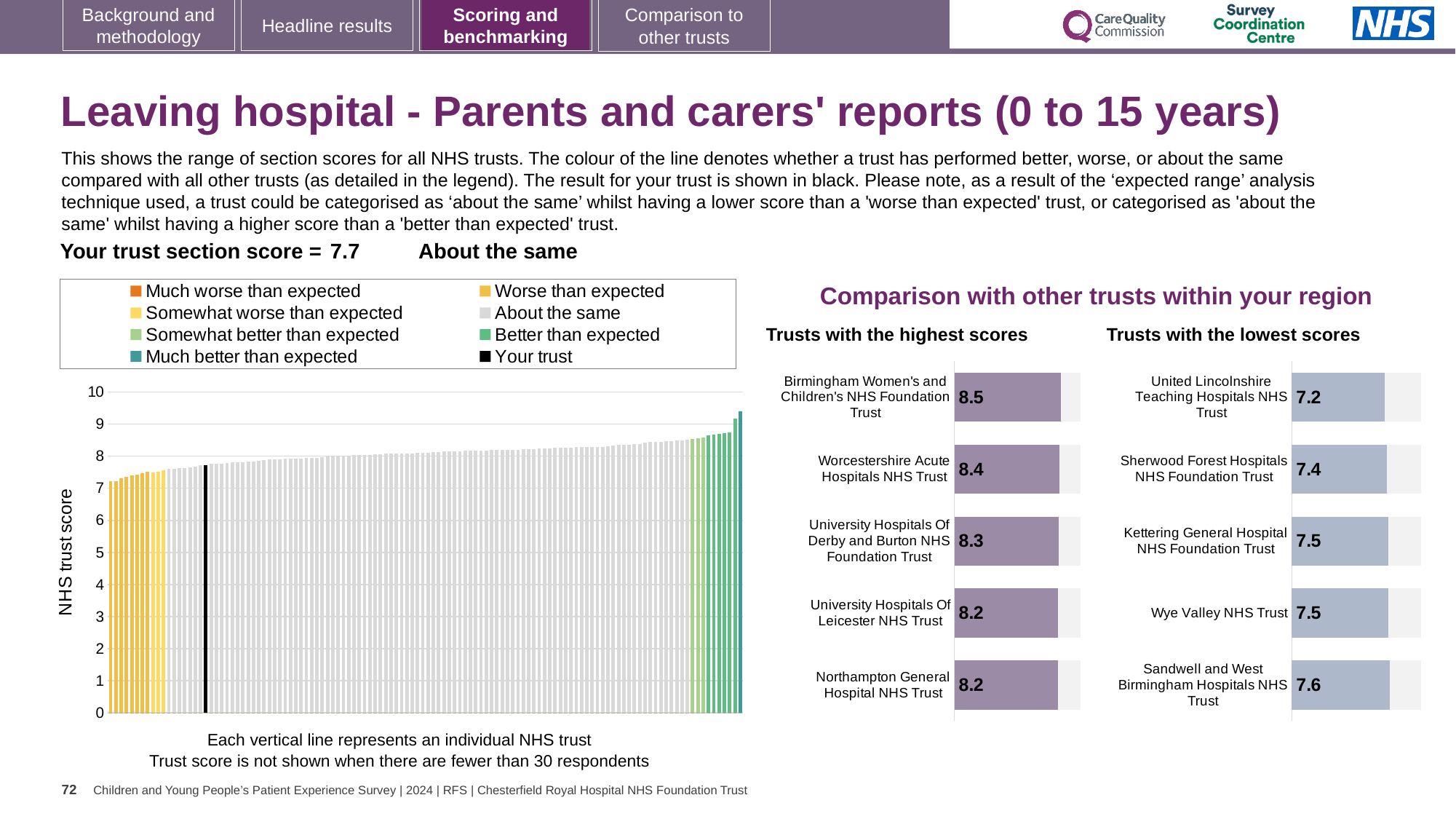
In the 'Trusts with the lowest scores' chart, what is the score for Sandwell and West Birmingham Hospitals NHS Trust? 7.6 In the NHS trust score chart on the left, what is the section score for your trust? 7.7 In the 'Trusts with the highest scores' chart, what is the score for Worcestershire Acute Hospitals NHS Trust? 8.4 In the 'Trusts with the lowest scores' chart, which has the higher score: Sherwood Forest Hospitals NHS Foundation Trust or Kettering General Hospital NHS Foundation Trust? Kettering General Hospital NHS Foundation Trust How many entries does the legend of the NHS trust score chart on the left list? 8 In the 'Trusts with the highest scores' chart, what is the difference between the scores of Birmingham Women's and Children's NHS Foundation Trust and Northampton General Hospital NHS Trust? 0.3 What kind of chart is the NHS trust score chart on the left of the slide? Bar chart In the NHS trust score chart on the left, do the values rise or fall from left to right? Rise In the 'Trusts with the highest scores' chart, which trust has the highest score? Birmingham Women's and Children's NHS Foundation Trust In the 'Trusts with the lowest scores' chart, what is the difference between the scores of Sandwell and West Birmingham Hospitals NHS Trust and United Lincolnshire Teaching Hospitals NHS Trust? 0.4 How many trusts are shown in the 'Trusts with the highest scores' chart? 5 In the 'Trusts with the lowest scores' chart, which trust has the lowest score? United Lincolnshire Teaching Hospitals NHS Trust